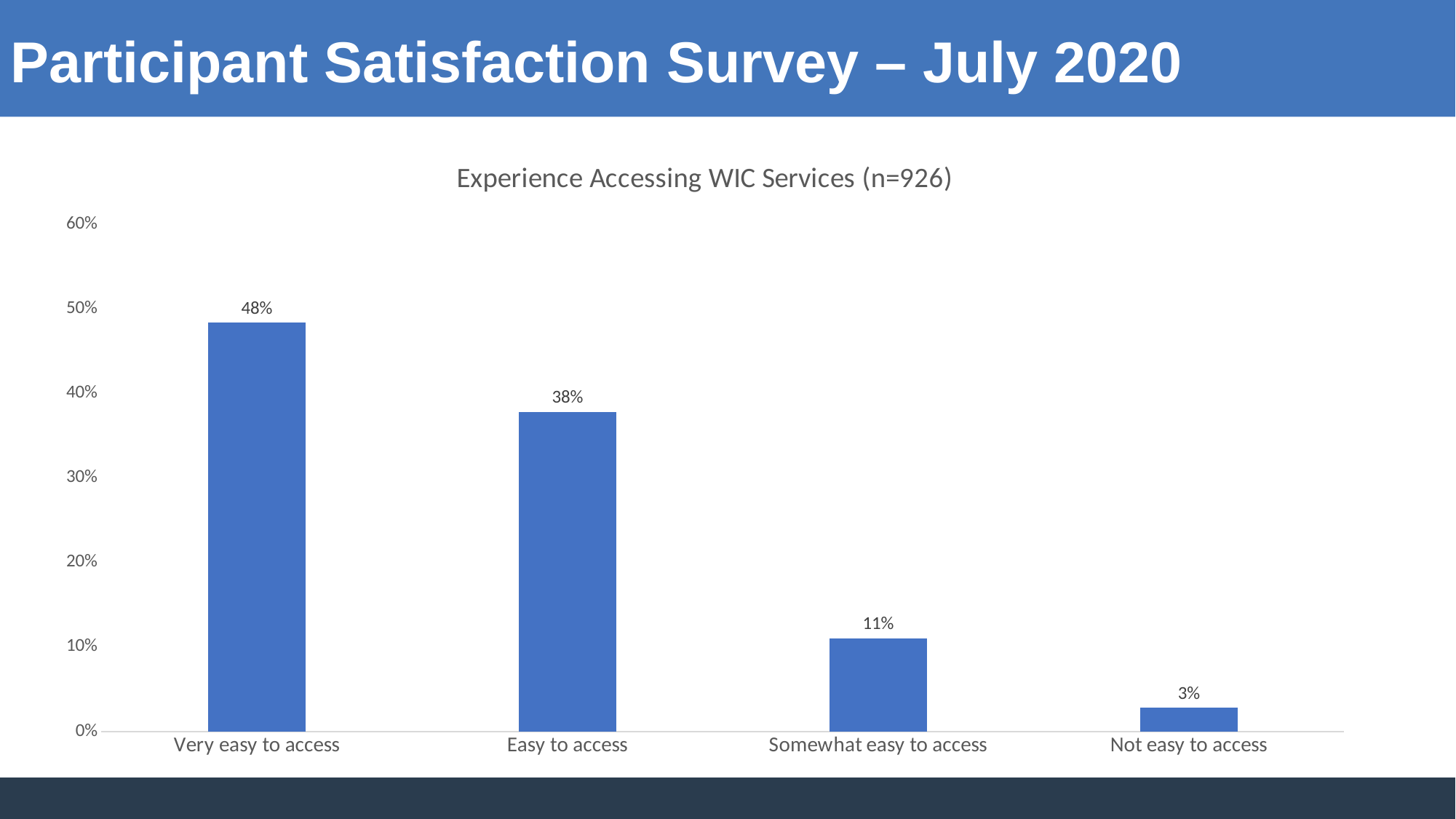
What is the value shown for 'Not easy to access'? 3% What percentage of respondents said WIC services were very easy to access? 48% What percentage of respondents chose 'Somewhat easy to access'? 11% What is the value for the 'Easy to access' category? 38% Which is larger, the value for 'Somewhat easy to access' or 'Not easy to access'? Somewhat easy to access Is the value for 'Easy to access' greater or less than 40%? less What is the difference between the 'Very easy to access' and 'Easy to access' values? 10% What is the sample size (n) given in the chart title? 926 Which category has the highest value? Very easy to access Which category has the lowest value? Not easy to access How many categories are shown on the x axis? 4 What kind of chart is shown on the slide? Bar chart